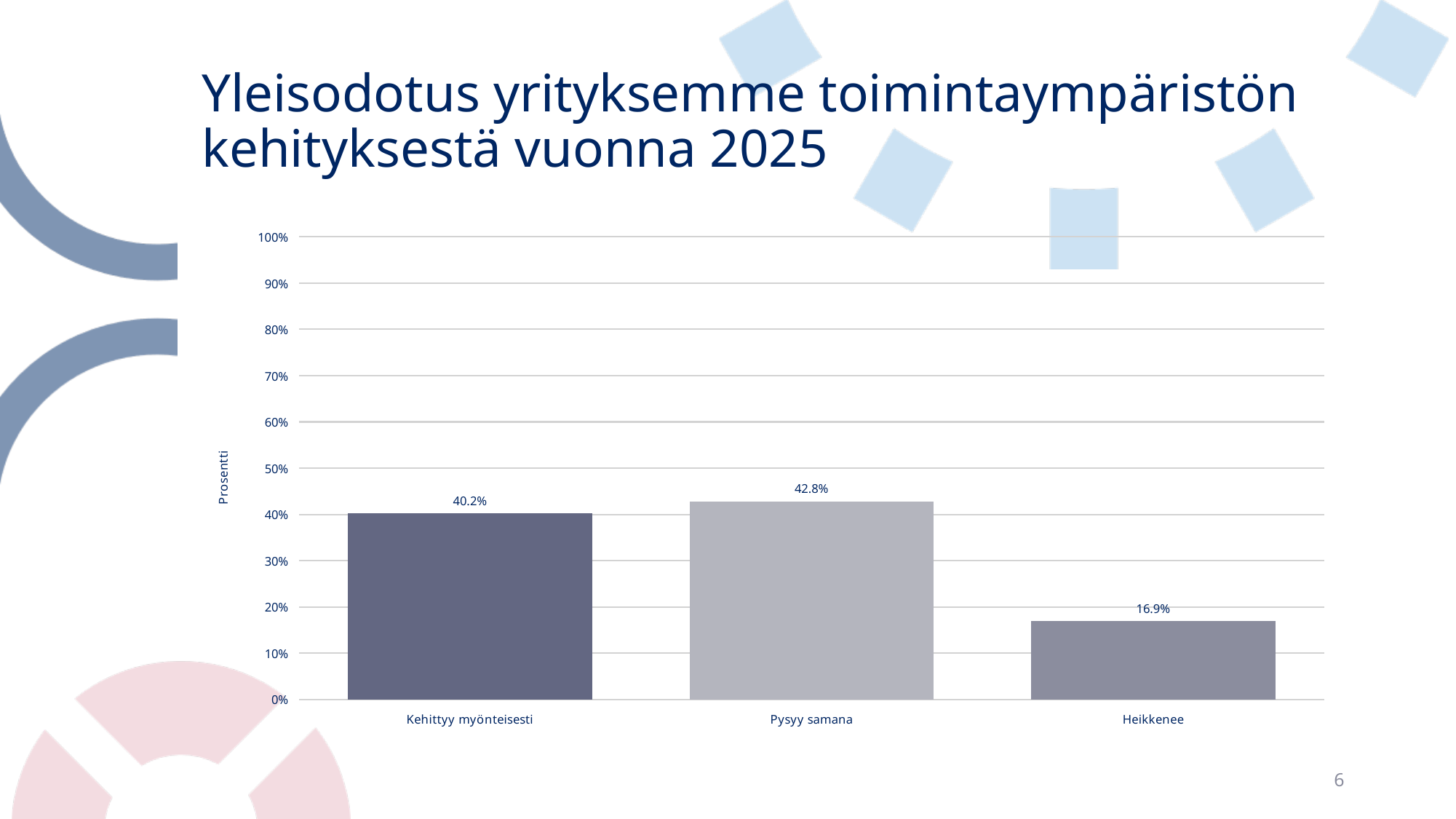
What is the value for Pysyy samana? 42.8% How many categories are shown on the x axis? 3 What is the label of the vertical axis? Prosentti What is the difference between the values for Kehittyy myönteisesti and Heikkenee? 23.3% Which category has the lowest value? Heikkenee Is the value for Heikkenee greater or less than 20%? less What is the difference between the values for Pysyy samana and Kehittyy myönteisesti? 2.6% Which category has the highest value? Pysyy samana What is the value for Kehittyy myönteisesti? 40.2% What is the value for Heikkenee? 16.9% Which is larger, the value for Kehittyy myönteisesti or the value for Heikkenee? Kehittyy myönteisesti What kind of chart is shown on the slide? bar chart